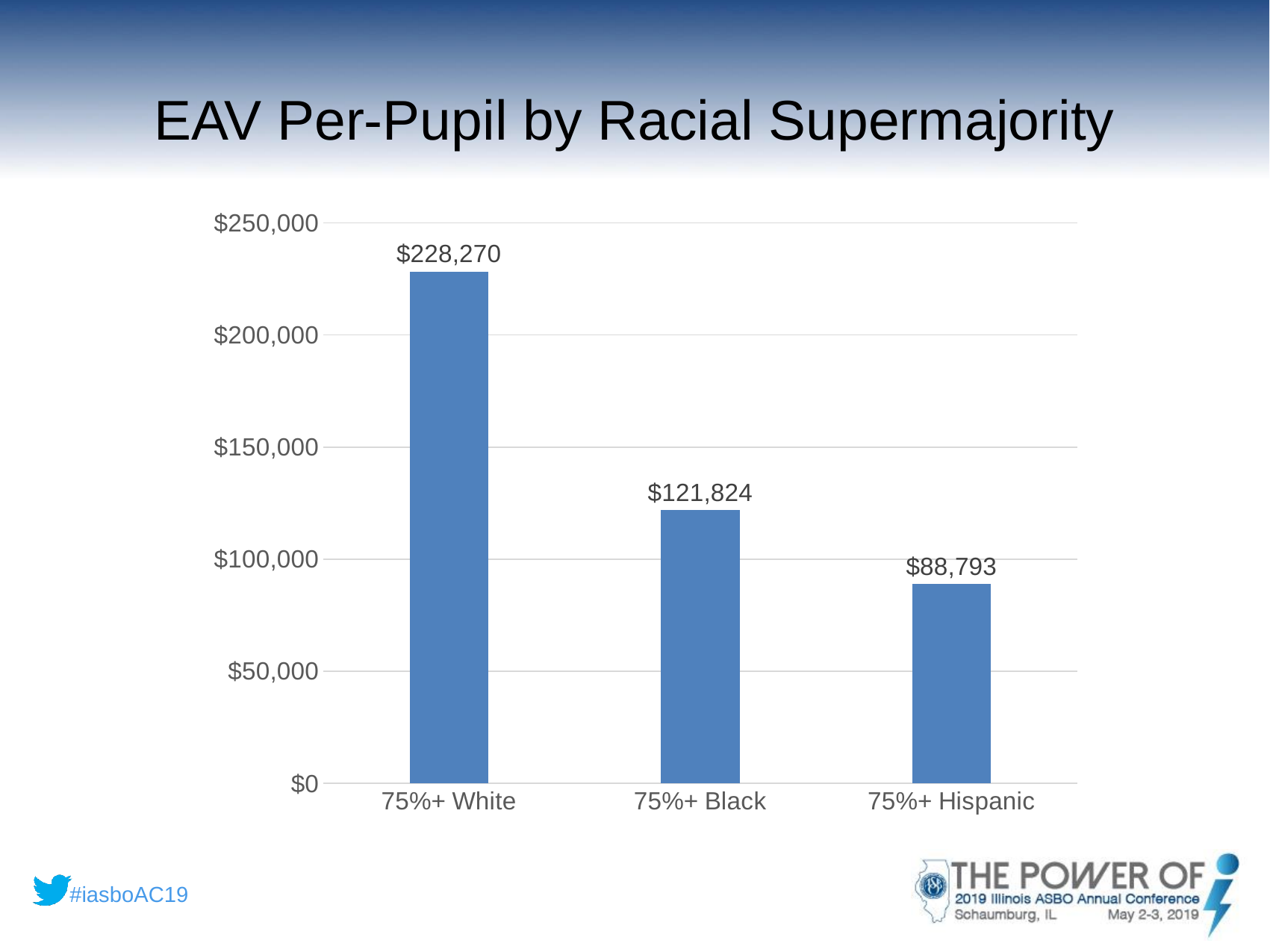
What is the EAV per-pupil value for 75%+ Black districts? $121,824 What kind of chart is shown on the slide? Bar chart What is the title of the chart on the slide? EAV Per-Pupil by Racial Supermajority What is the difference in EAV per-pupil between 75%+ White and 75%+ Black districts? $106,446 Which category has the highest EAV per-pupil? 75%+ White What is the EAV per-pupil value for 75%+ Hispanic districts? $88,793 What is the EAV per-pupil value for 75%+ White districts? $228,270 How many categories are shown in the chart? 3 Which category has the lowest EAV per-pupil? 75%+ Hispanic What is the difference in EAV per-pupil between 75%+ Black and 75%+ Hispanic districts? $33,031 Which has a larger EAV per-pupil, 75%+ Black or 75%+ Hispanic? 75%+ Black Is the value for 75%+ Hispanic greater or less than $100,000? less